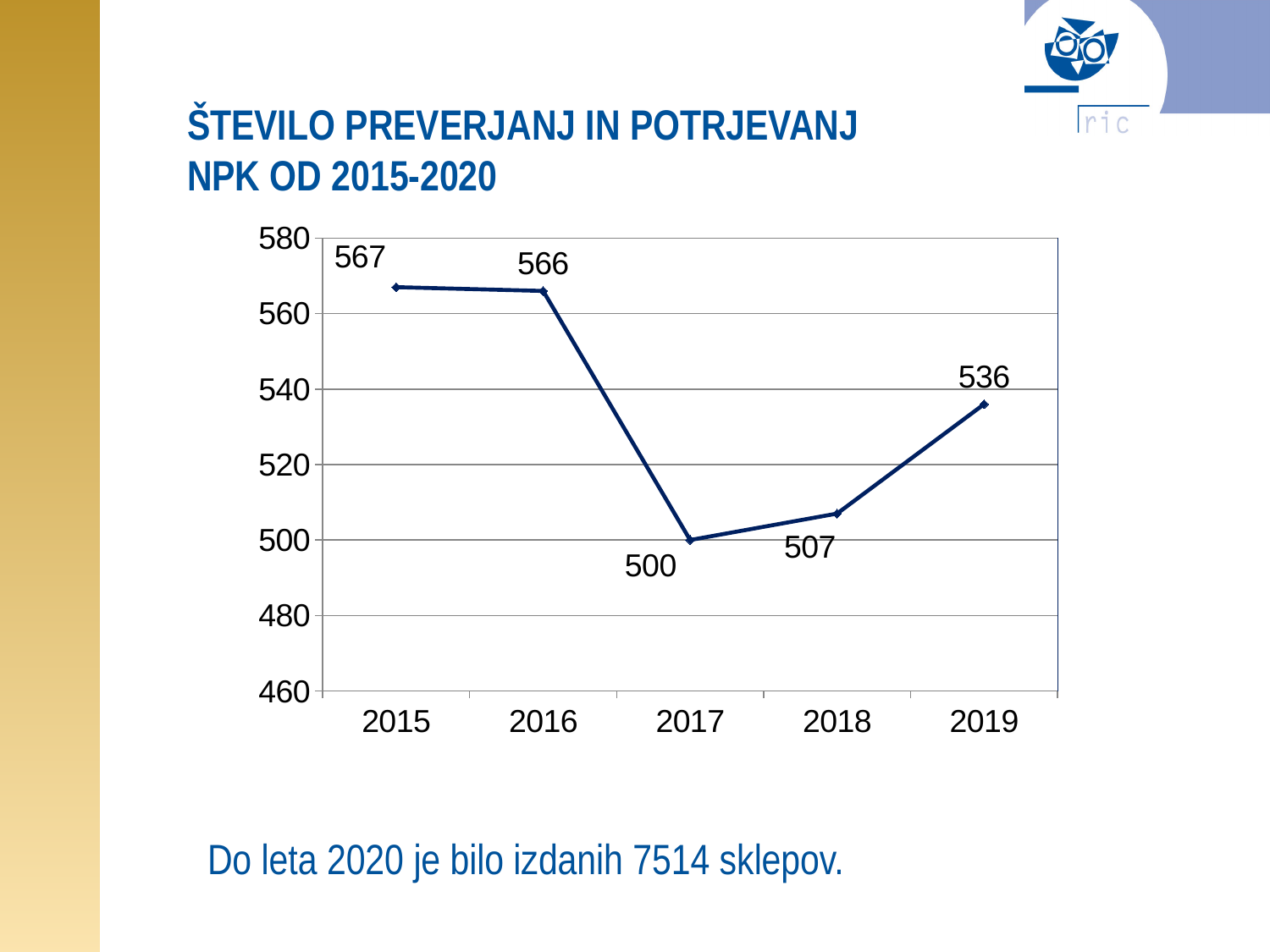
Which year has the lowest value? 2017 What is the difference between the values for 2016 and 2017? 66 How many years are plotted on the chart? 5 Do the values rise or fall from 2017 to 2019? rise Is the value for 2018 greater or less than 520? less What is the value for 2017? 500 What is the difference between the values for 2019 and 2018? 29 Which is larger, the value for 2018 or the value for 2019? 2019 What is the value for 2015? 567 What kind of chart is shown on the slide? line chart What is the value for 2019? 536 Which year has the highest value? 2015